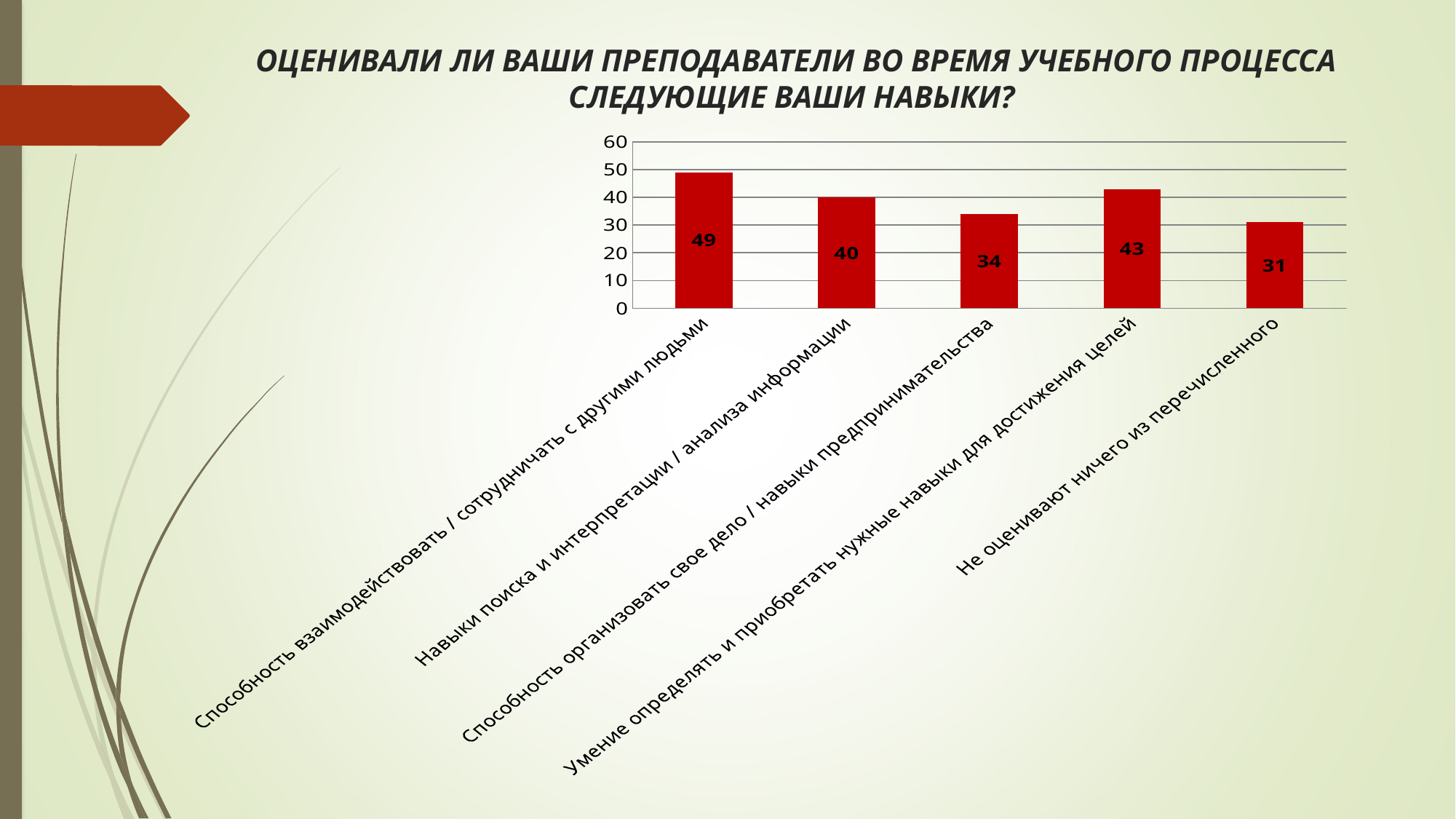
Which category has the lowest value? Не оценивают ничего из перечисленного What colour are the bars in the chart? red What is the maximum value shown on the vertical axis? 60 How many categories are shown in the chart? 5 What is the value for "Способность взаимодействовать / сотрудничать с другими людьми"? 49 What is the value for "Не оценивают ничего из перечисленного"? 31 What is the value for "Навыки поиска и интерпретации / анализа информации"? 40 What is the difference between the values for "Умение определять и приобретать нужные навыки для достижения целей" and "Способность организовать свое дело / навыки предпринимательства"? 9 Which category has the highest value? Способность взаимодействовать / сотрудничать с другими людьми Is the value for "Способность организовать свое дело / навыки предпринимательства" greater or less than 40? less Which is larger: the value for "Навыки поиска и интерпретации / анализа информации" or for "Умение определять и приобретать нужные навыки для достижения целей"? Умение определять и приобретать нужные навыки для достижения целей What kind of chart is shown on the slide? bar chart